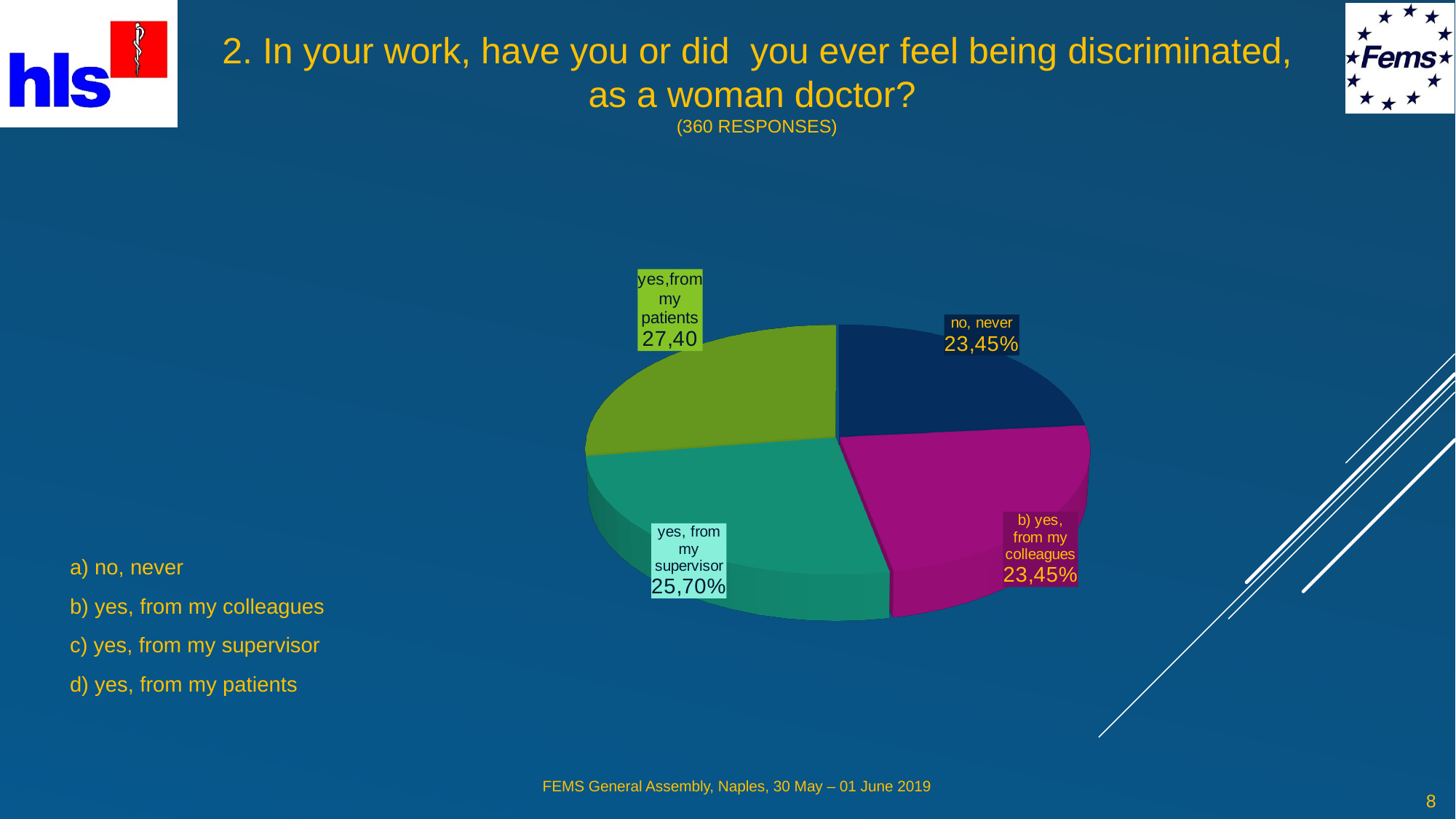
What kind of chart is shown on the slide? pie chart What is the difference between the "yes, from my supervisor" share and the "no, never" share? 2,25 What percentage of respondents answered "no, never"? 23,45% What percentage of respondents answered "yes, from my supervisor"? 25,70% What is the difference between the "yes, from my patients" share and the "yes, from my supervisor" share? 1,70 What colour is the "no, never" slice? dark blue Which is larger: the share for "yes, from my supervisor" or for "b) yes, from my colleagues"? yes, from my supervisor How many slices does the pie chart have? 4 How many responses does the slide say the chart is based on? 360 What value is shown for the "yes, from my patients" slice? 27,40 What percentage of respondents answered "b) yes, from my colleagues"? 23,45% Which response has the largest share of the pie? yes, from my patients